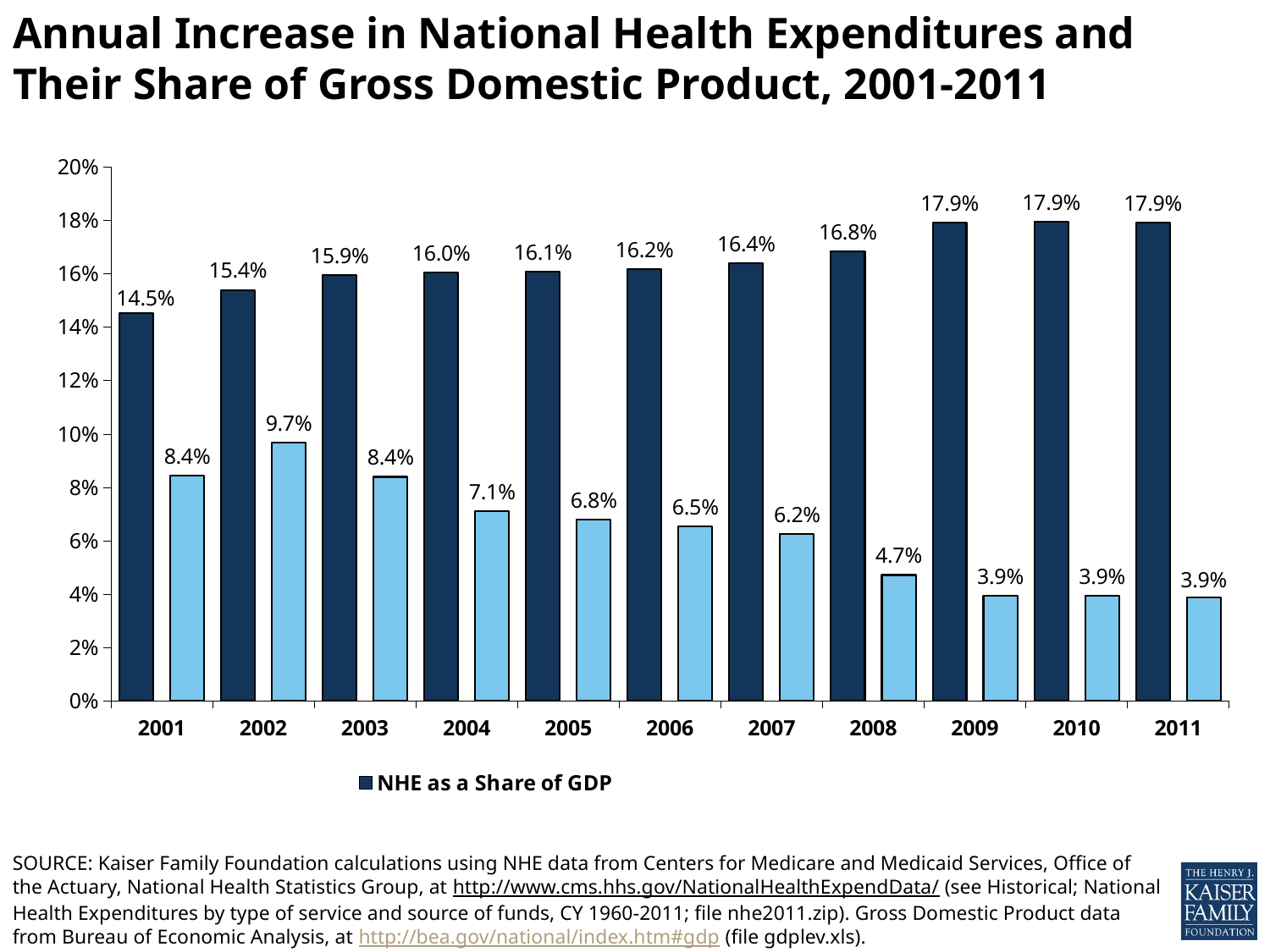
In which year was NHE as a Share of GDP lowest? 2001 In which year is the light blue bar highest? 2002 Does NHE as a Share of GDP generally rise or fall from 2001 to 2011? Rise By how many percentage points did NHE as a Share of GDP increase from 2001 to 2011? 3.4 percentage points Which is larger: NHE as a Share of GDP in 2005 or in 2009? 2009 What value is shown by the light blue bar for 2002? 9.7% What kind of chart is shown on the slide? Bar chart What was NHE as a Share of GDP in 2008? 16.8% How many years are shown on the x axis? 11 What was NHE as a Share of GDP in 2001? 14.5% What value is shown by the light blue bar for 2007? 6.2% What is the difference between the light blue bar values for 2002 and 2008? 5.0 percentage points